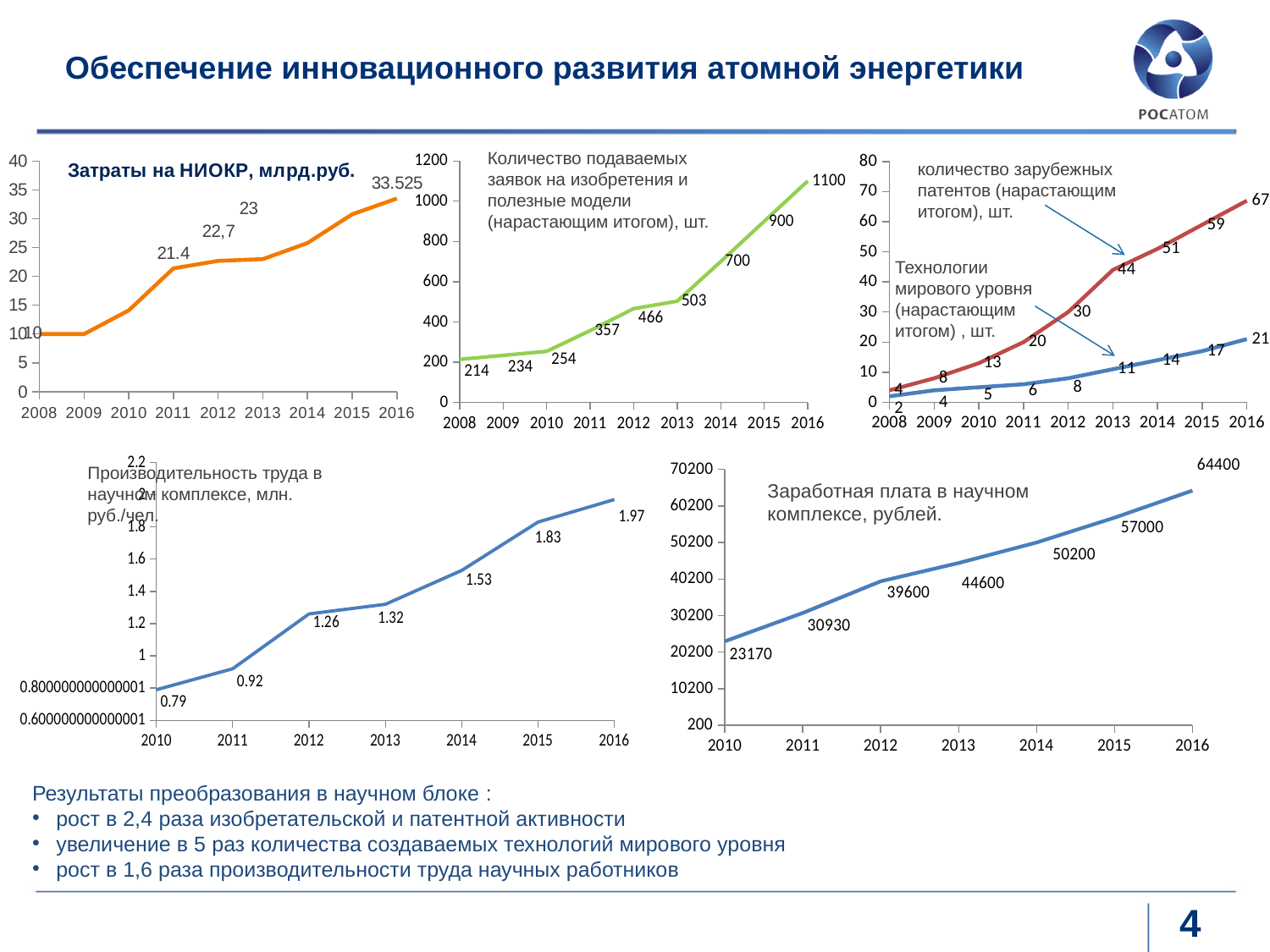
In the chart 'Количество подаваемых заявок на изобретения и полезные модели (нарастающим итогом), шт.', what is the difference between the 2015 and 2014 values? 200 In the chart 'Заработная плата в научном комплексе, рублей.', what is the value for 2012? 39600 In the top-right chart, what is the value of 'Технологии мирового уровня (нарастающим итогом), шт.' for 2016? 21 In the chart 'Количество подаваемых заявок на изобретения и полезные модели (нарастающим итогом), шт.', what is the value for 2011? 357 In the chart 'Производительность труда в научном комплексе, млн. руб./чел.', what is the value for 2014? 1.53 In the chart 'Количество подаваемых заявок на изобретения и полезные модели (нарастающим итогом), шт.', what is the value for 2016? 1100 In the top-right chart, what is the value of 'количество зарубежных патентов (нарастающим итогом), шт.' for 2013? 44 In the chart 'Затраты на НИОКР, млрд.руб.', what is the value for 2016? 33.525 In the chart 'Затраты на НИОКР, млрд.руб.', what is the value for 2011? 21.4 In the top-right chart, which series has the higher value in 2016: 'количество зарубежных патентов' or 'Технологии мирового уровня'? количество зарубежных патентов In the chart 'Заработная плата в научном комплексе, рублей.', do the values rise or fall from 2010 to 2016? rise In the chart 'Производительность труда в научном комплексе, млн. руб./чел.', which year has the lowest value? 2010